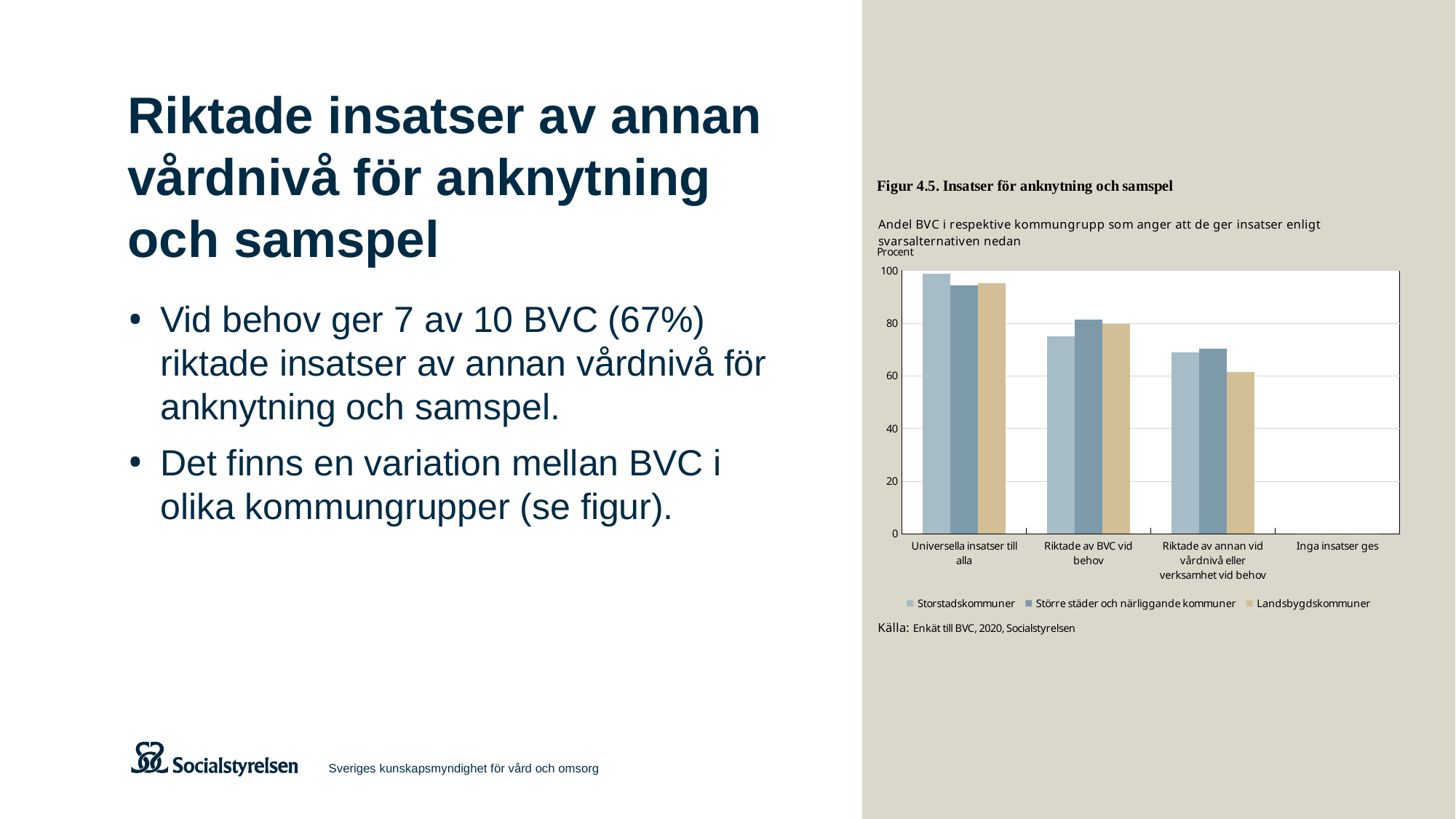
Is the value for Storstadskommuner in the category 'Riktade av BVC vid behov' greater or less than 80? less Which category has the highest value for Storstadskommuner? Universella insatser till alla Is the value for Storstadskommuner in the category 'Universella insatser till alla' greater or less than 80? greater Is the value for Landsbygdskommuner in the category 'Riktade av annan vid vårdnivå eller verksamhet vid behov' greater or less than 80? less What is the title of the figure on the slide? Figur 4.5. Insatser för anknytning och samspel Which category has the lowest value for Landsbygdskommuner? Inga insatser ges In the category 'Riktade av BVC vid behov', which is larger: Storstadskommuner or Större städer och närliggande kommuner? Större städer och närliggande kommuner Do the values for Storstadskommuner rise or fall from left to right along the x axis? fall How many categories are shown on the x axis of the chart? 4 What kind of chart is shown on the slide? Bar chart In the category 'Riktade av annan vid vårdnivå eller verksamhet vid behov', which is larger: Storstadskommuner or Landsbygdskommuner? Storstadskommuner How many series does the chart legend list? 3